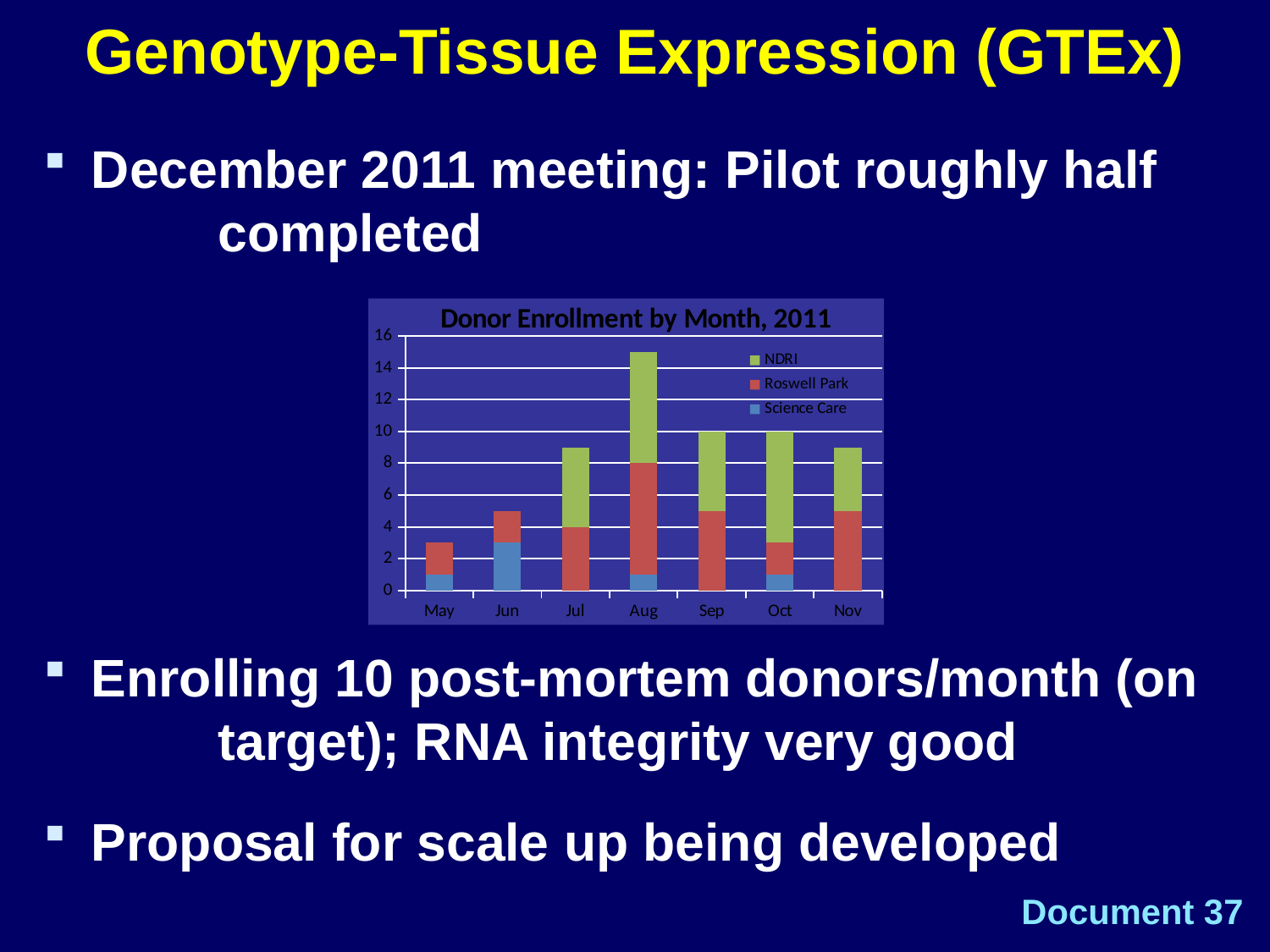
Is the total donor enrollment for Jun greater or less than 6? less Which series are listed in the chart legend? NDRI, Roswell Park, Science Care Is the total donor enrollment for Aug greater or less than 14? greater Which month has a higher total donor enrollment, Aug or Sep? Aug Does total donor enrollment rise or fall from May to Aug? rise Which month has the highest total donor enrollment? Aug Is the total donor enrollment for May greater or less than 4? less What is the title of the chart? Donor Enrollment by Month, 2011 How many months are shown on the x axis of the chart? 7 What kind of chart is shown on the slide? bar chart Which month has the lowest total donor enrollment? May How many series does the chart legend list? 3